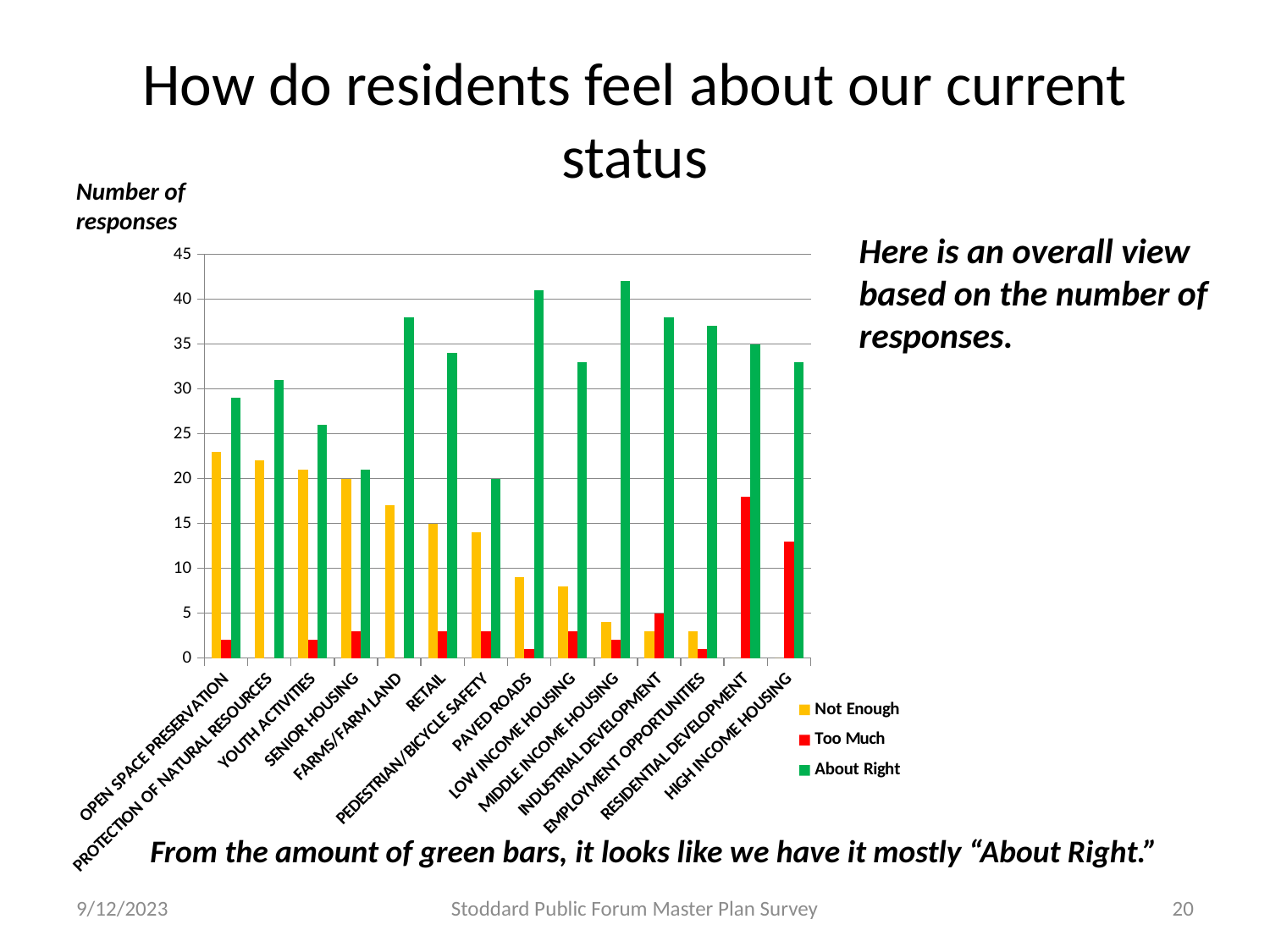
What colour represents the 'About Right' series in the legend? green What kind of chart is shown on the slide? bar chart Which category has the highest 'Too Much' value? Residential Development Which is larger: the 'Too Much' value for Residential Development or for High Income Housing? Residential Development Is the 'About Right' value for Farms/Farm Land greater or less than 35? greater How many categories are shown along the x axis? 14 For Open Space Preservation, which is larger: the 'Not Enough' value or the 'About Right' value? About Right Is the 'Not Enough' value for Open Space Preservation greater or less than 20? greater Is the 'Too Much' value for Residential Development greater or less than 15? greater How many series does the legend list? 3